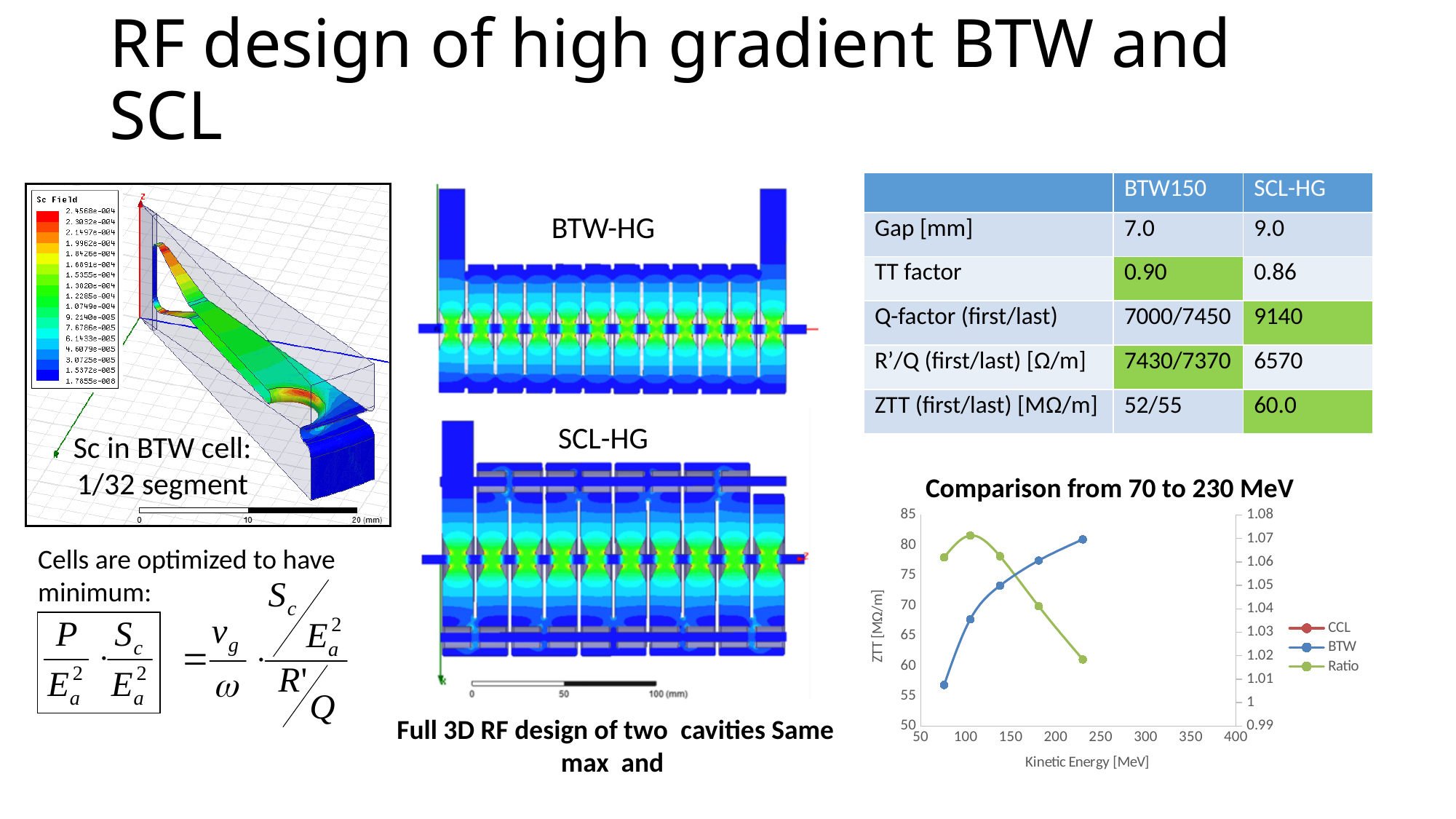
In the "Comparison from 70 to 230 MeV" chart, is the Ratio series lowest at its first point or its last point? its last point In the "Comparison from 70 to 230 MeV" chart, is the Ratio value at its peak greater or less than 1.06? greater In the "Comparison from 70 to 230 MeV" chart, does the Ratio series rise or fall between about 100 MeV and 230 MeV? fall In the "Comparison from 70 to 230 MeV" chart, is the BTW value at the lowest kinetic energy point greater or less than 60? less In the "Comparison from 70 to 230 MeV" chart, does the BTW series rise or fall as kinetic energy increases? rise What is the x-axis label of the "Comparison from 70 to 230 MeV" chart? Kinetic Energy [MeV] In the "Comparison from 70 to 230 MeV" chart, is the BTW value at the highest kinetic energy point greater or less than 75? greater What kind of chart is the "Comparison from 70 to 230 MeV" chart? line chart How many data points are plotted for the BTW series in the "Comparison from 70 to 230 MeV" chart? 5 Which series are listed in the legend of the "Comparison from 70 to 230 MeV" chart? CCL, BTW, Ratio How many series does the legend of the "Comparison from 70 to 230 MeV" chart list? 3 In the "Comparison from 70 to 230 MeV" chart, at which kinetic energy point is the BTW series highest, the first or the last? the last